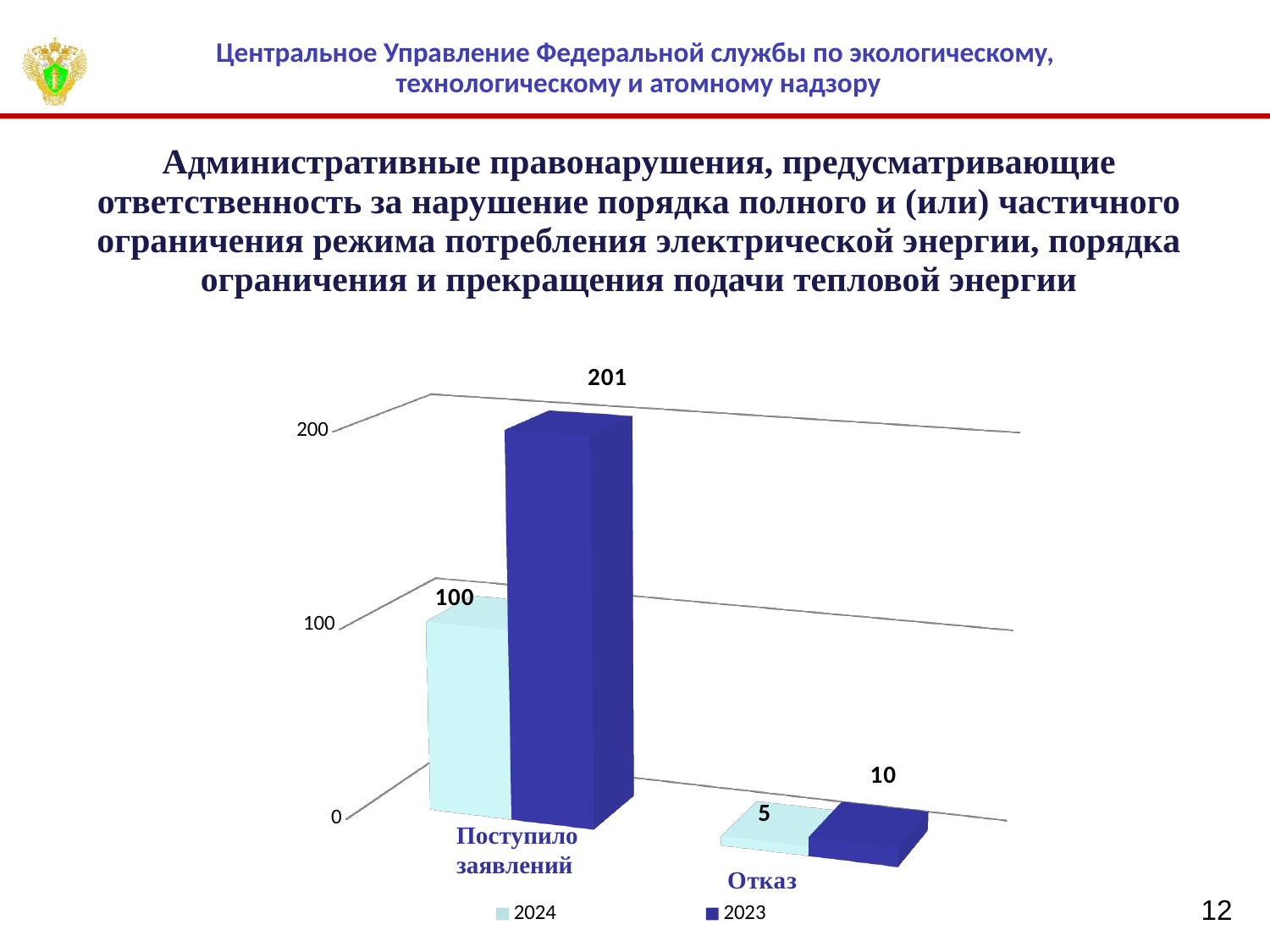
What is the value for 2024 in the "Отказ" category? 5 How many categories are shown on the x axis? 2 What is the difference between the 2023 and 2024 values for "Отказ"? 5 What is the value for 2023 in the "Отказ" category? 10 Which series has the higher value for "Поступило заявлений", 2024 or 2023? 2023 What kind of chart is shown on the slide? Bar chart Which category has the lowest value for 2024? Отказ What is the difference between the 2023 and 2024 values for "Поступило заявлений"? 101 How many series does the legend list? 2 What is the value for 2024 in the "Поступило заявлений" category? 100 What is the value for 2023 in the "Поступило заявлений" category? 201 Which category has the highest value for 2023? Поступило заявлений